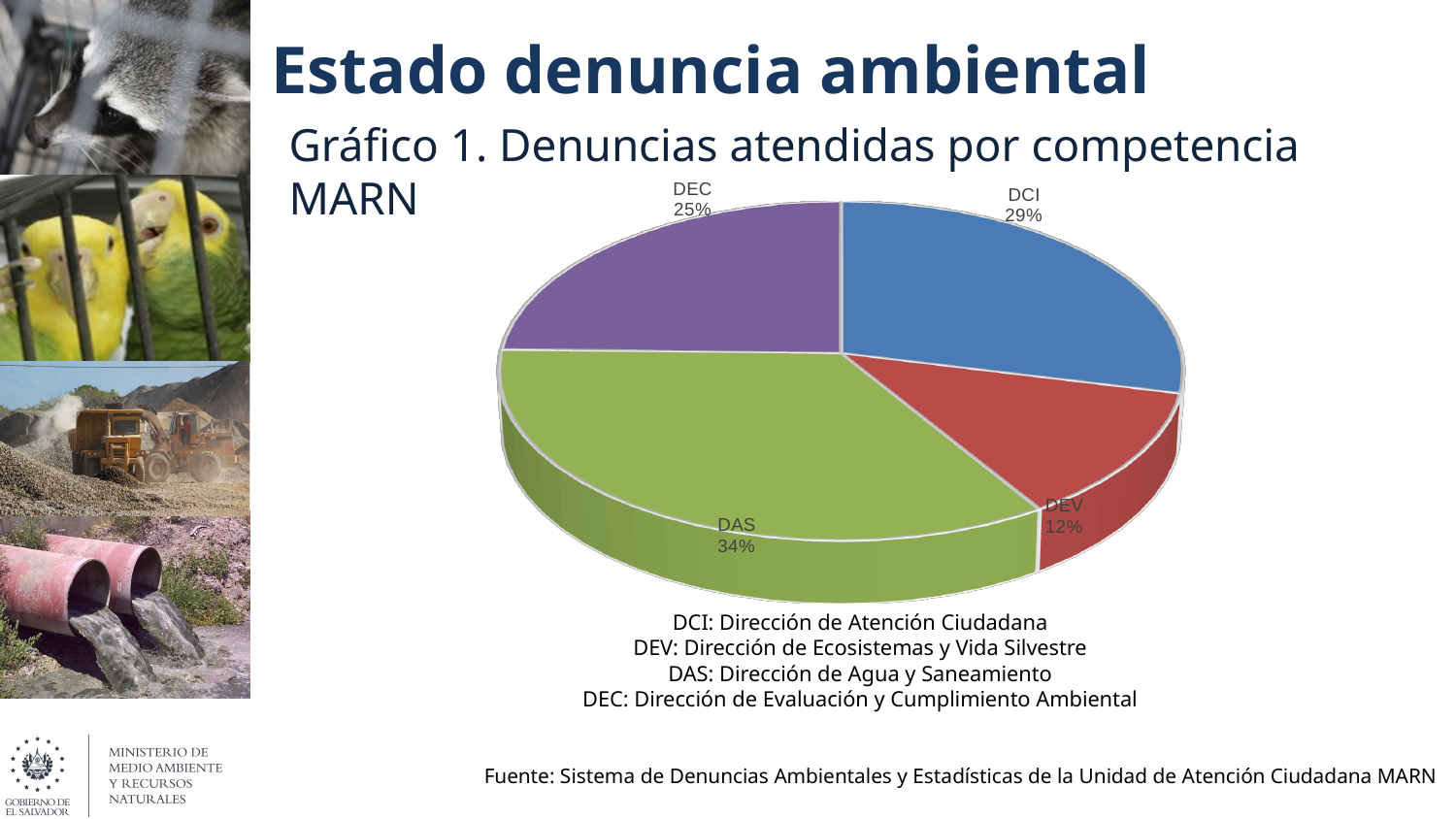
Which category has the smallest slice of the pie? DEV How many categories are shown in the pie chart? 4 What type of chart is shown on the slide? Pie chart What percentage is shown for DEC? 25% What colour is the DAS slice? Green What percentage is shown for DCI? 29% What is the title of the chart? Gráfico 1. Denuncias atendidas por competencia MARN What percentage is shown for DEV? 12% Which category has the largest slice of the pie? DAS Which is larger, the share for DCI or the share for DEC? DCI What share of the pie does DAS represent? 34% What is the difference in percentage points between DAS and DEV? 22